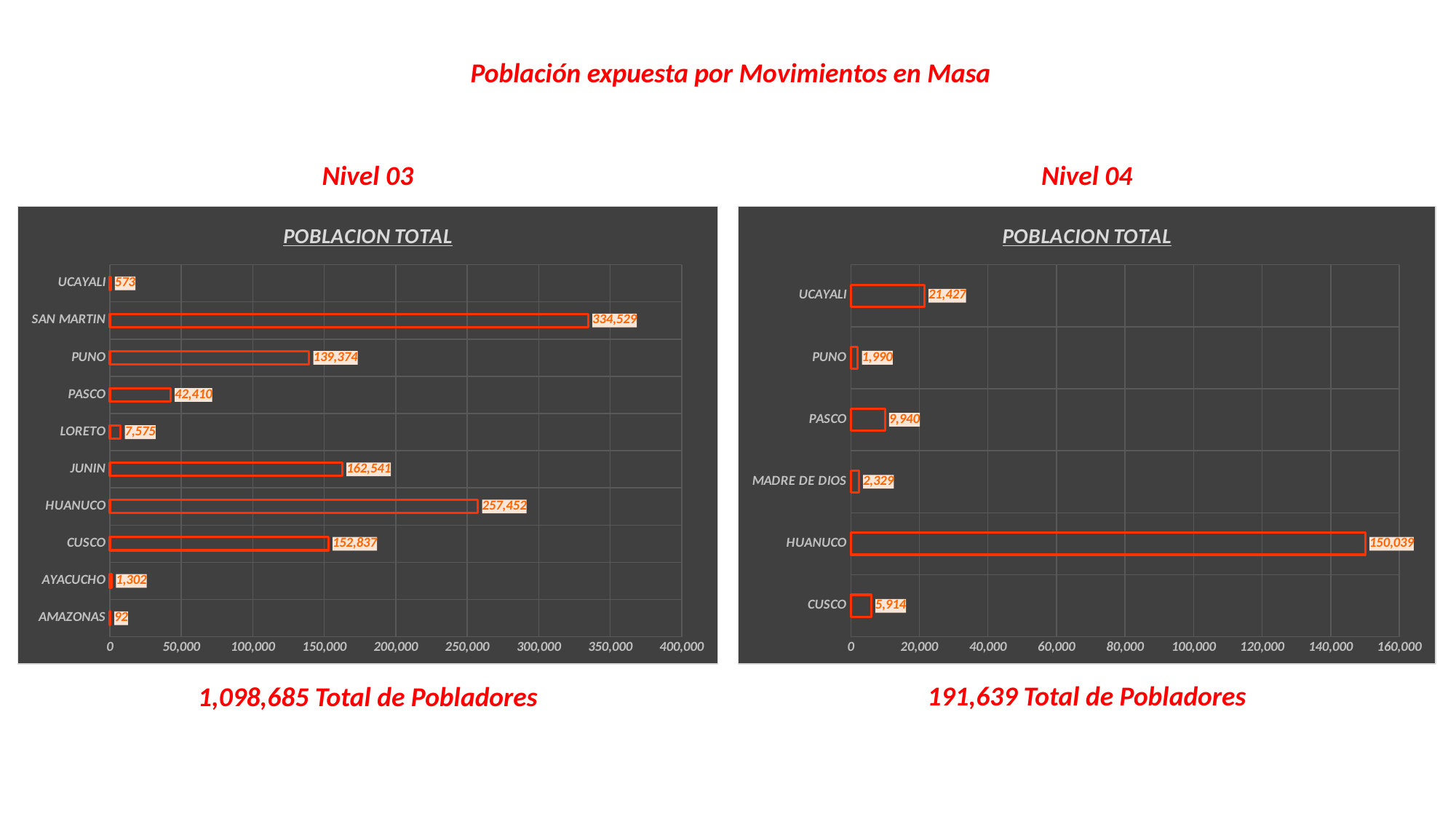
In the Nivel 04 chart, what is the value for MADRE DE DIOS? 2,329 In the Nivel 03 chart, which category has the highest value? SAN MARTIN In the Nivel 03 chart, which category has the lowest value? AMAZONAS In the Nivel 04 chart, which is larger, the value for PASCO or the value for CUSCO? PASCO In the Nivel 03 chart, what is the difference between the values for HUANUCO and JUNIN? 94,911 In the Nivel 04 chart, which category has the highest value? HUANUCO What kind of chart is the Nivel 03 chart? Bar chart In the Nivel 04 chart, what is the value for UCAYALI? 21,427 In the Nivel 04 chart, which category has the lowest value? PUNO In the Nivel 03 chart, what is the value for PUNO? 139,374 How many categories are shown in the Nivel 04 chart? 6 In the Nivel 03 chart, what is the value for SAN MARTIN? 334,529